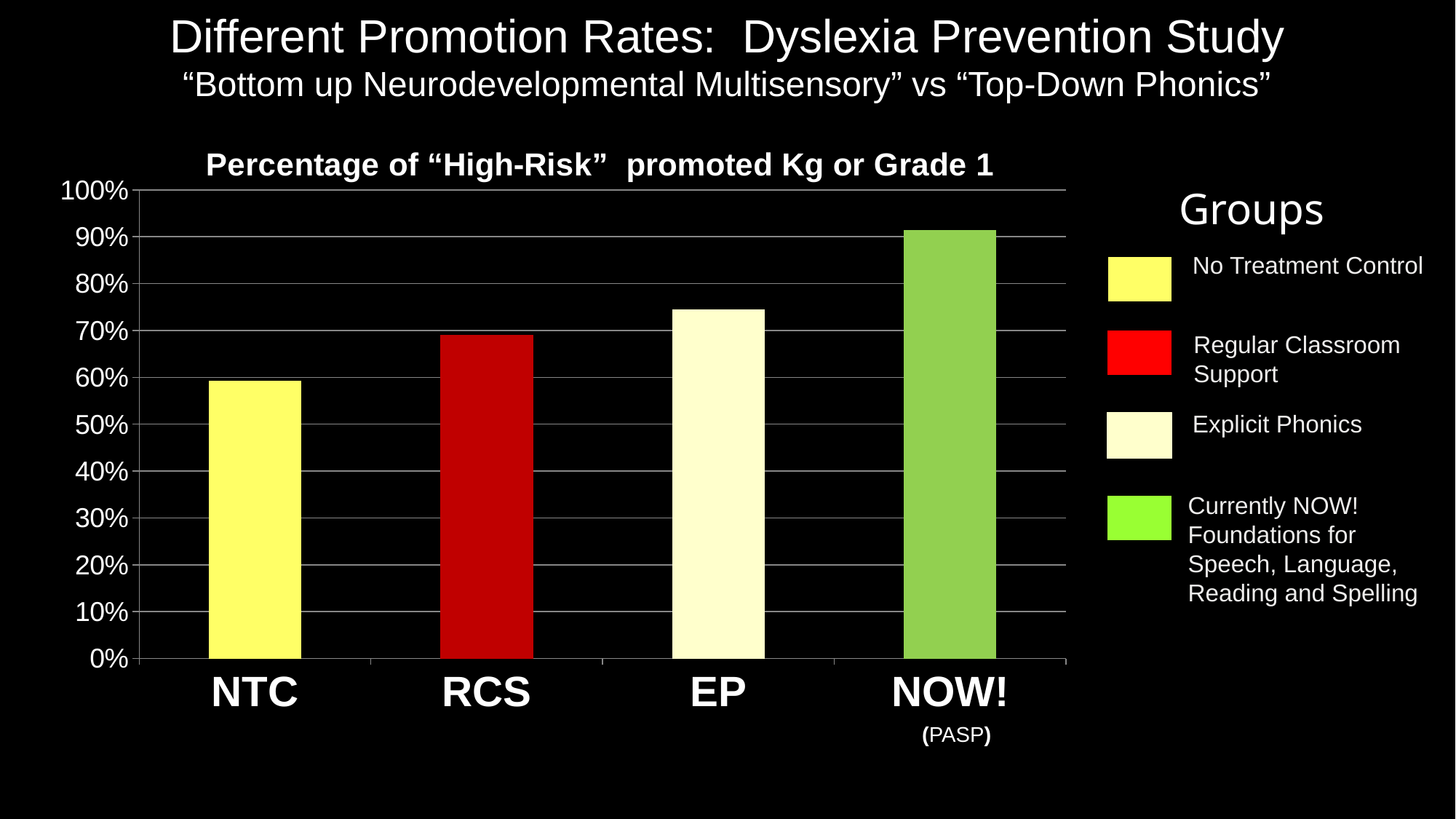
Which group has the highest percentage of high-risk students promoted? NOW! Is the value for NTC greater or less than 70%? less Which group has the lowest percentage of high-risk students promoted? NTC What does the legend say the green bar represents? Currently NOW! Foundations for Speech, Language, Reading and Spelling Is the value for NOW! greater or less than 80%? greater How many groups are plotted on the x axis of the chart? 4 Is the value for NTC greater or less than 50%? greater What kind of chart is shown on the slide? bar chart Which group has a higher promotion rate, RCS or EP? EP Do the bar values rise or fall from NTC to NOW! along the x axis? rise